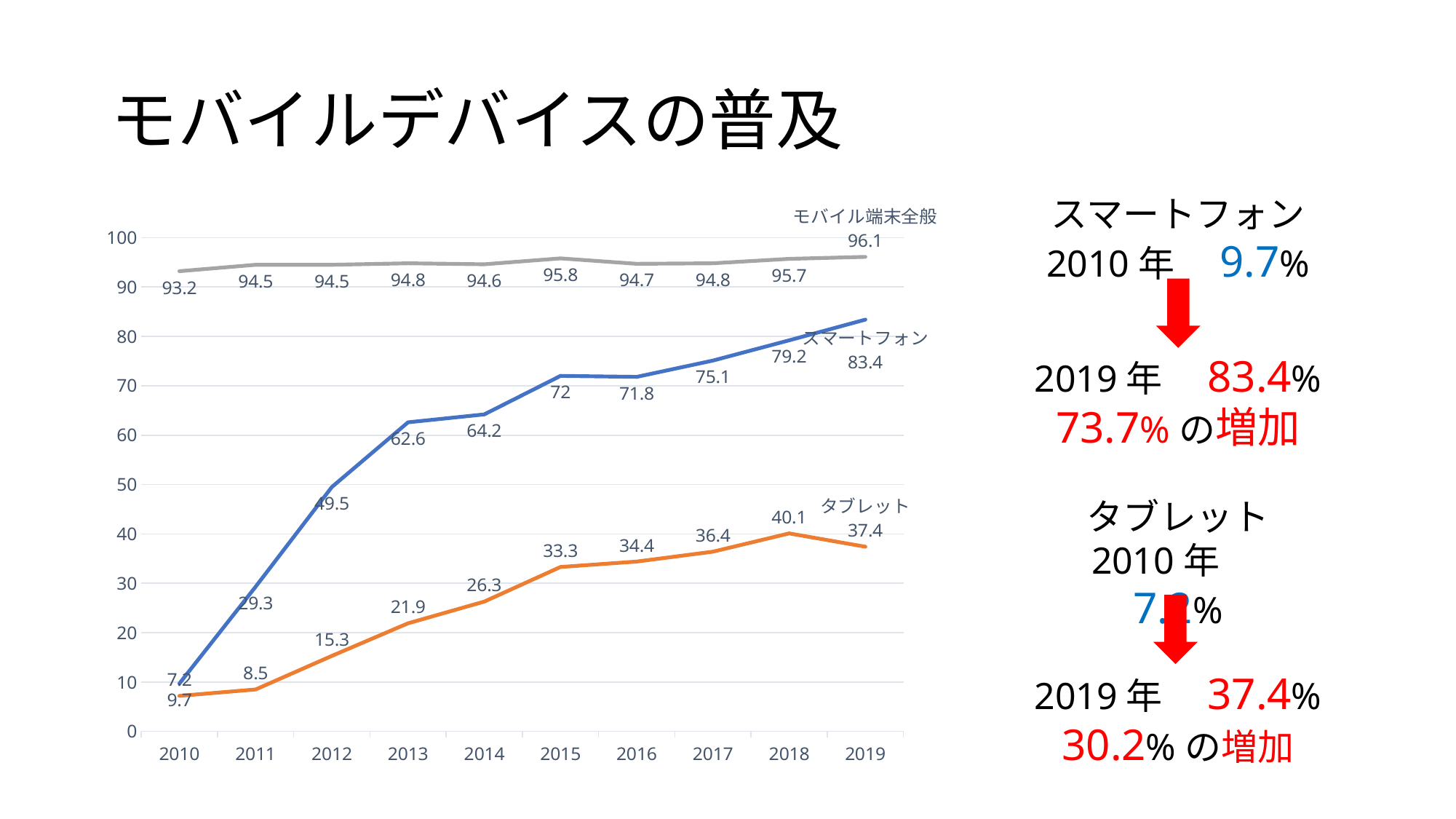
How many years are plotted on the x axis? 10 What is the value for タブレット in 2018? 40.1 How many series are plotted in the chart? 3 Which is larger in 2016: the スマートフォン value or the タブレット value? スマートフォン What is the value for モバイル端末全般 in 2010? 93.2 What is the difference between the スマートフォン values in 2019 and 2010? 73.7 What is the value for スマートフォン in 2013? 62.6 In which year is the タブレット value highest? 2018 What kind of chart is shown on the slide? line chart In which year is the スマートフォン value lowest? 2010 What is the value for スマートフォン in 2019? 83.4 Does the タブレット value rise or fall from 2018 to 2019? fall